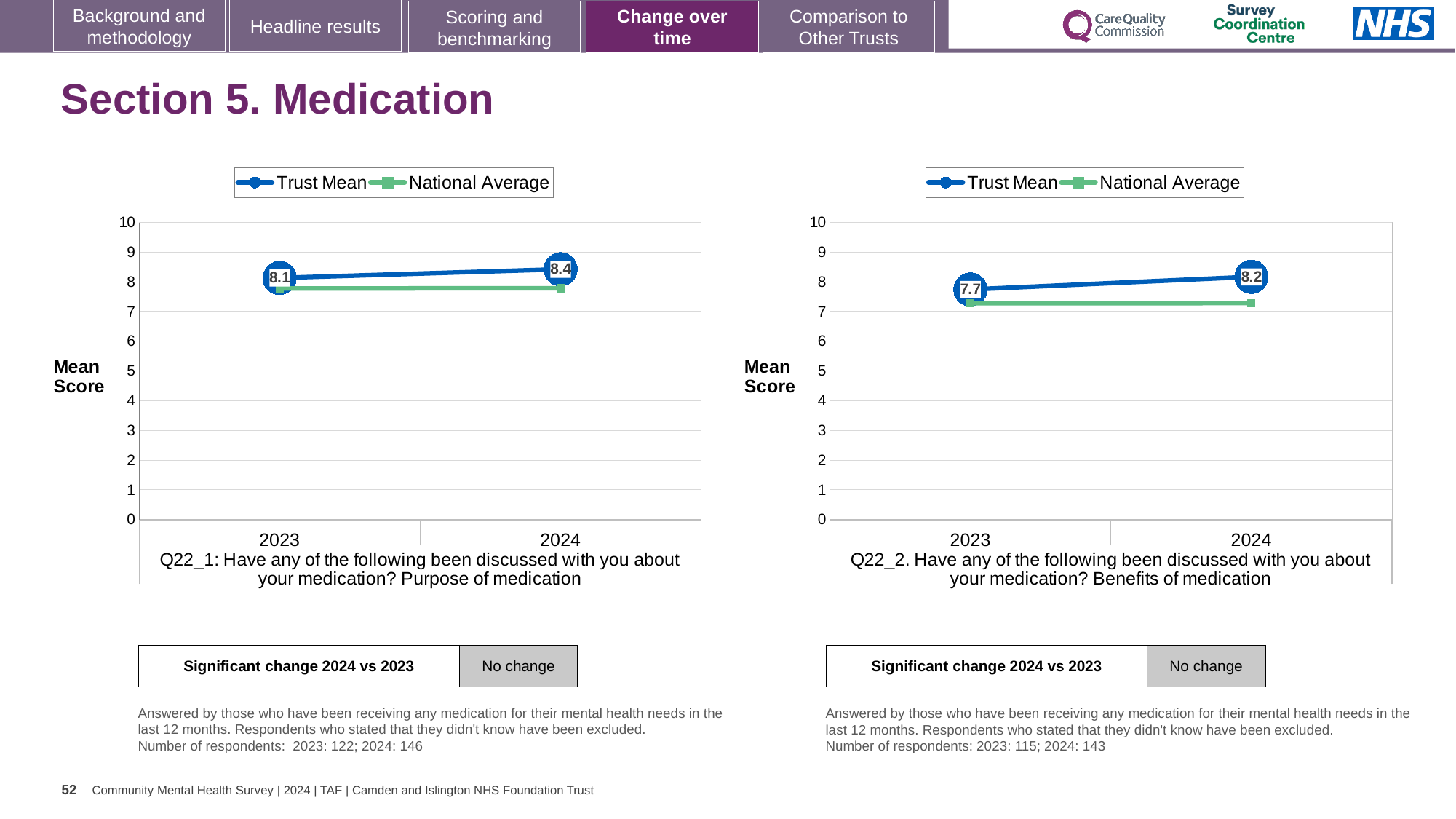
In the right chart (Q22_2: Benefits of medication), what is the Trust Mean for 2024? 8.2 What type of chart is used on this slide? line chart In the left chart (Q22_1), by how much did the Trust Mean change from 2023 to 2024? 0.3 In the right chart (Q22_2: Benefits of medication), what is the Trust Mean for 2023? 7.7 In the left chart (Q22_1), is the National Average for 2024 greater or less than 8? less In the right chart (Q22_2), which is larger in 2024, the Trust Mean or the National Average? Trust Mean In the left chart (Q22_1: Purpose of medication), what is the Trust Mean for 2023? 8.1 In the left chart (Q22_1: Purpose of medication), what is the Trust Mean for 2024? 8.4 How many series does the legend of the left chart list? 2 In the right chart (Q22_2), is the National Average for 2023 greater or less than 7? greater In the right chart (Q22_2), does the Trust Mean rise or fall from 2023 to 2024? rise In the right chart (Q22_2), what is the difference between the Trust Mean in 2024 and in 2023? 0.5